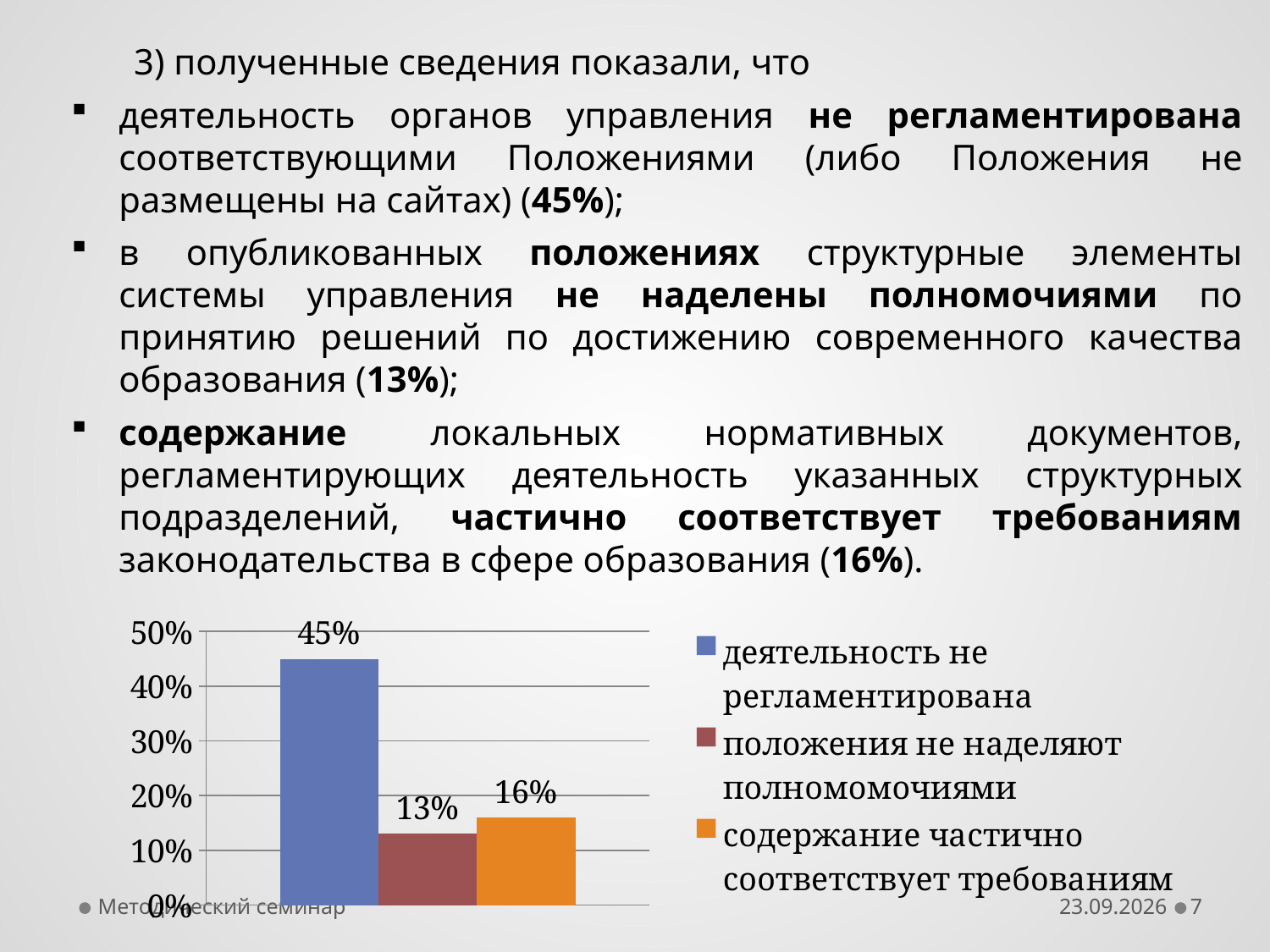
What is the value of the bar for "положения не наделяют полномомочиями"? 13% What is the value of the bar for "деятельность не регламентирована"? 45% Which legend entry has the lowest value in the chart? положения не наделяют полномомочиями What kind of chart is shown at the bottom of the slide? bar chart What colour is the bar for "содержание частично соответствует требованиям"? orange How many entries does the chart legend list? 3 Which legend entry has the highest value in the chart? деятельность не регламентирована What is the difference between the values for "содержание частично соответствует требованиям" and "положения не наделяют полномомочиями"? 3% What is the value of the bar for "содержание частично соответствует требованиям"? 16% How many bars are plotted in the chart? 3 Which is larger: the value for "содержание частично соответствует требованиям" or for "положения не наделяют полномомочиями"? содержание частично соответствует требованиям What is the difference between the values for "деятельность не регламентирована" and "содержание частично соответствует требованиям"? 29%